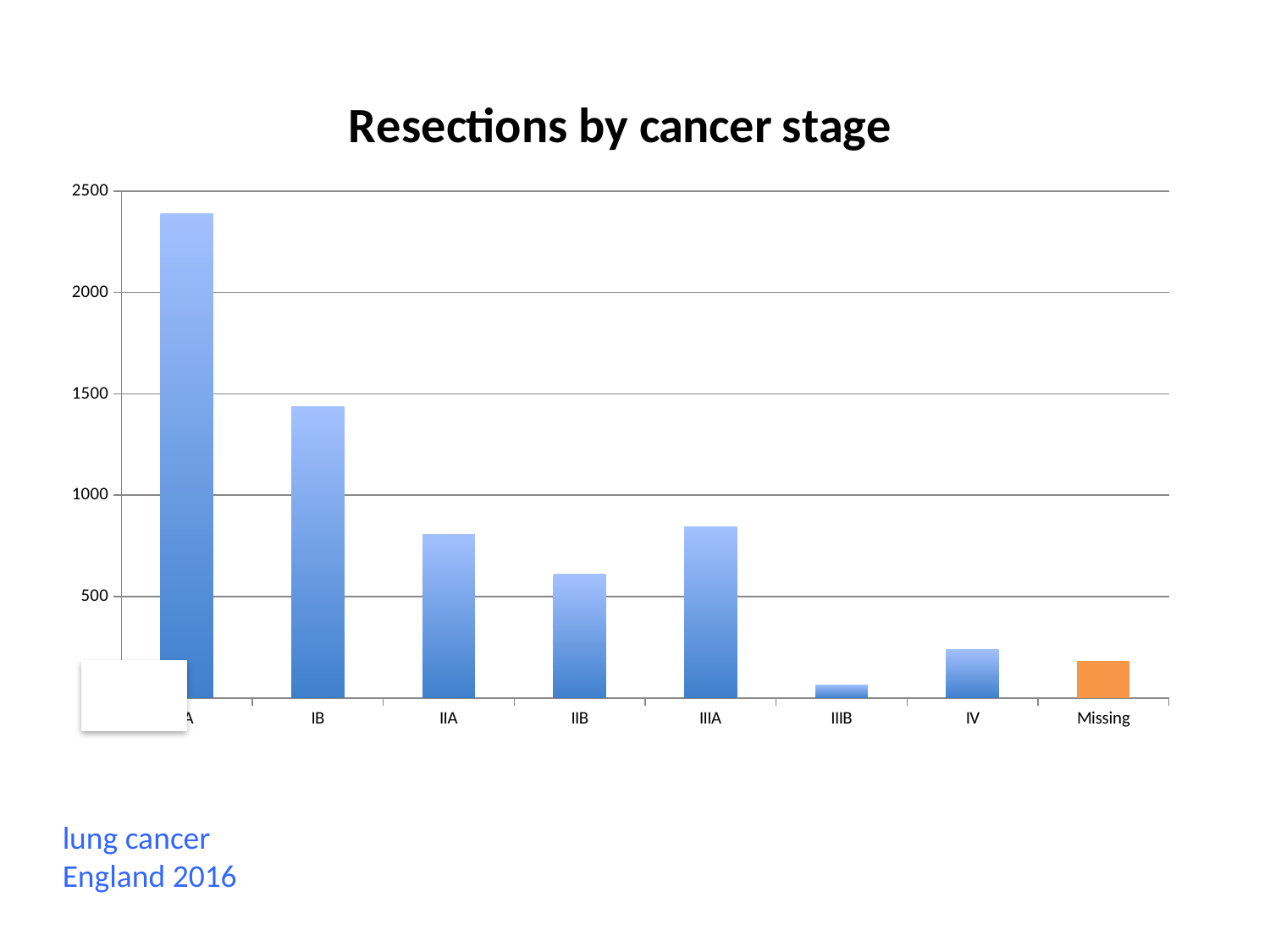
Is the value for IB greater or less than 1500? less Is the value for IB greater or less than 1000? greater What is the title of the chart? Resections by cancer stage How many bars are plotted in the chart? 8 Which has more resections, IB or IIA? IB What kind of chart is shown on the slide? bar chart Which category has the lowest number of resections? IIIB Which has more resections, IIIA or IIB? IIIA Which bar is coloured differently (orange) from the others? Missing Is the value for IIB greater or less than 500? greater